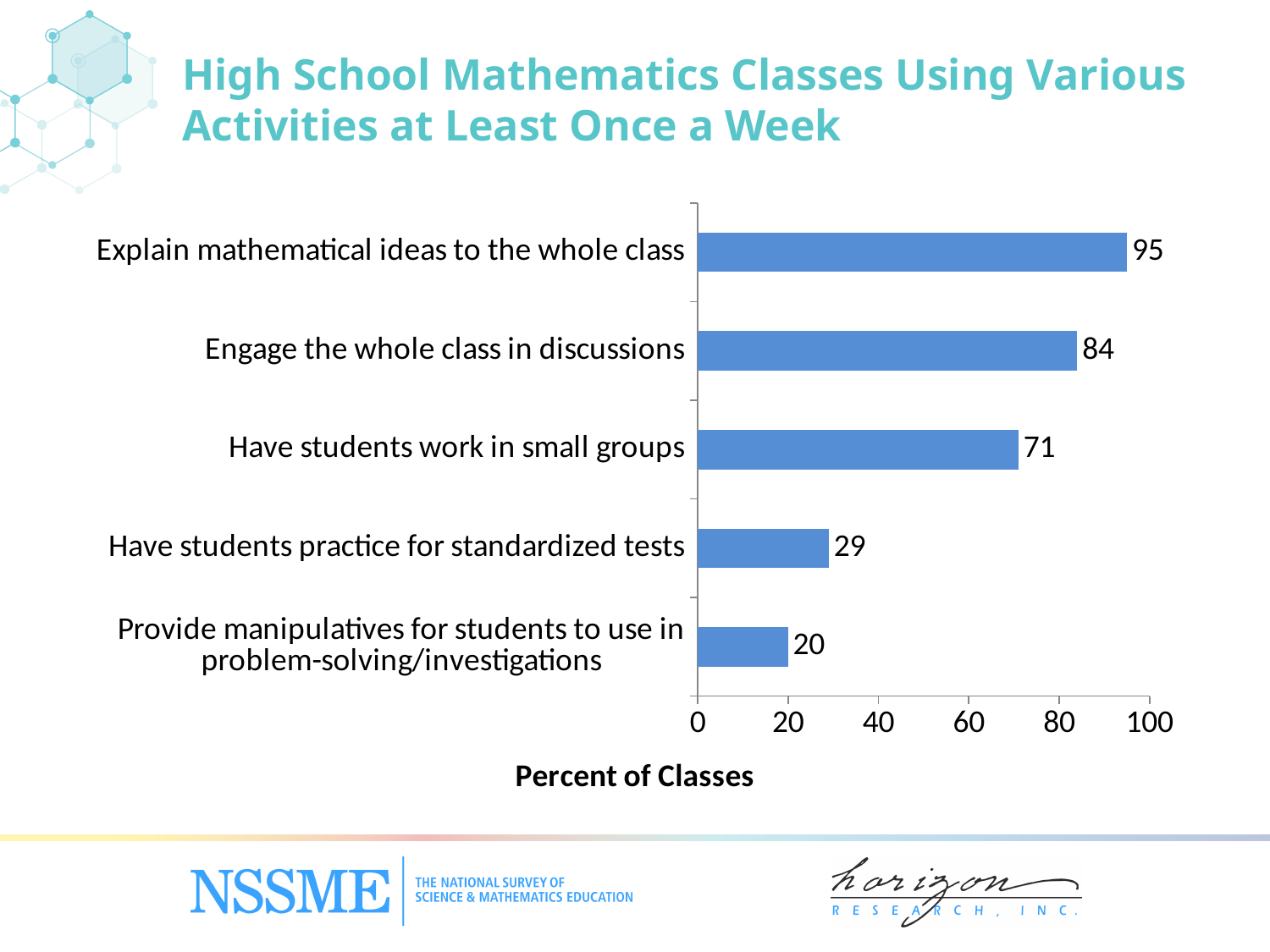
What is the label of the horizontal axis? Percent of Classes Is the value for 'Engage the whole class in discussions' greater or less than 80? greater Which activity has the highest percent of classes? Explain mathematical ideas to the whole class What percent of classes explain mathematical ideas to the whole class at least once a week? 95 What is the value for 'Have students work in small groups'? 71 Which is larger: 'Have students work in small groups' or 'Have students practice for standardized tests'? Have students work in small groups What is the difference between the highest and lowest values in the chart? 75 What is the difference between 'Engage the whole class in discussions' and 'Have students practice for standardized tests'? 55 How many activities are shown in the chart? 5 What is the value for 'Provide manipulatives for students to use in problem-solving/investigations'? 20 What kind of chart is shown on the slide? Bar chart Which activity has the lowest percent of classes? Provide manipulatives for students to use in problem-solving/investigations